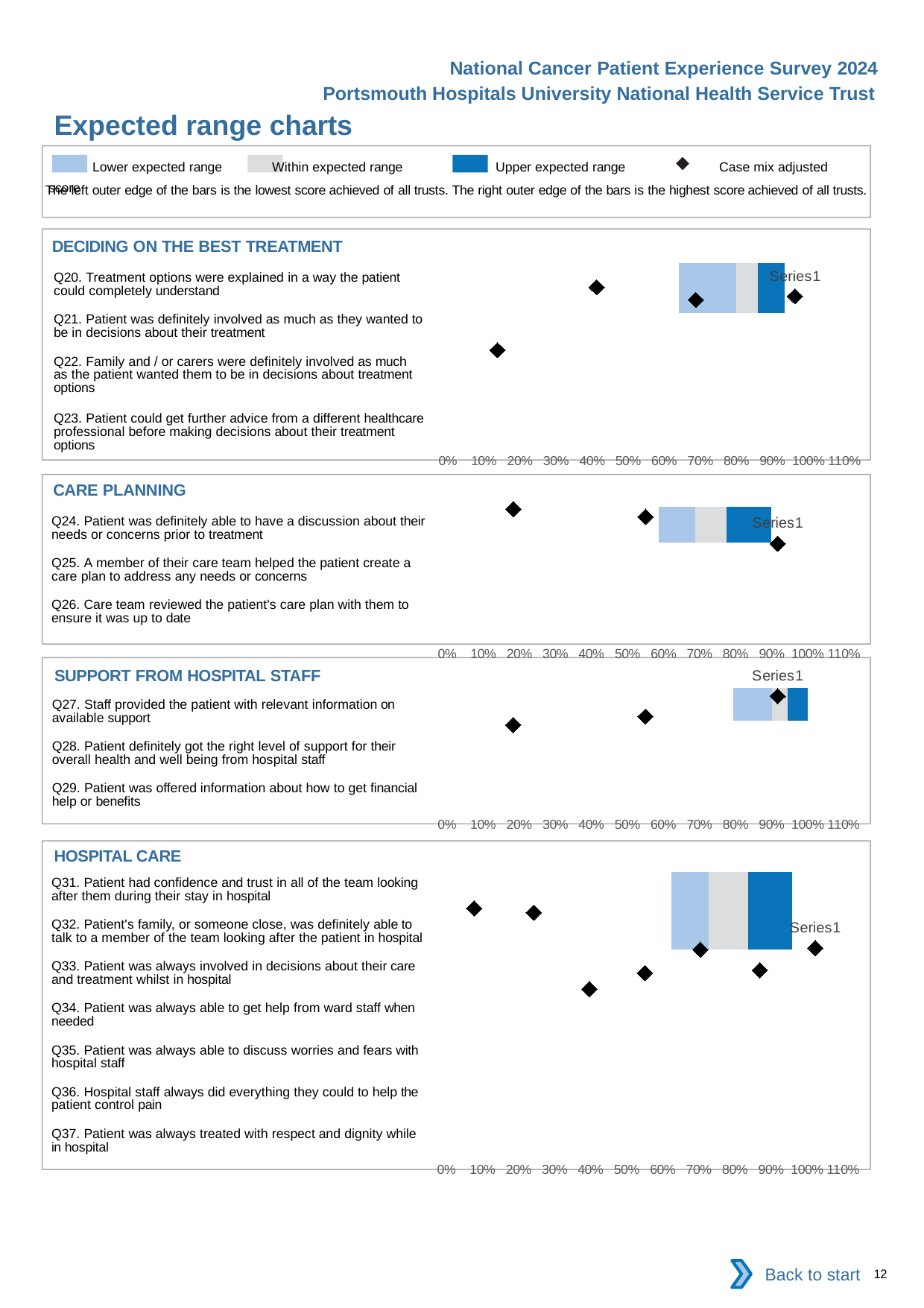
How many questions are listed in the 'CARE PLANNING' chart? 3 What kind of chart is used in the 'DECIDING ON THE BEST TREATMENT' section? bar chart According to the legend, which colour represents the 'Upper expected range'? dark blue How many questions are listed in the 'SUPPORT FROM HOSPITAL STAFF' chart? 3 What is the title of the chart that lists Q24 to Q26? CARE PLANNING How many expected range charts are shown on the slide? 4 How many entries does the legend at the top of the slide list? 4 What is the highest percentage tick shown on the x axis of the 'HOSPITAL CARE' chart? 110%